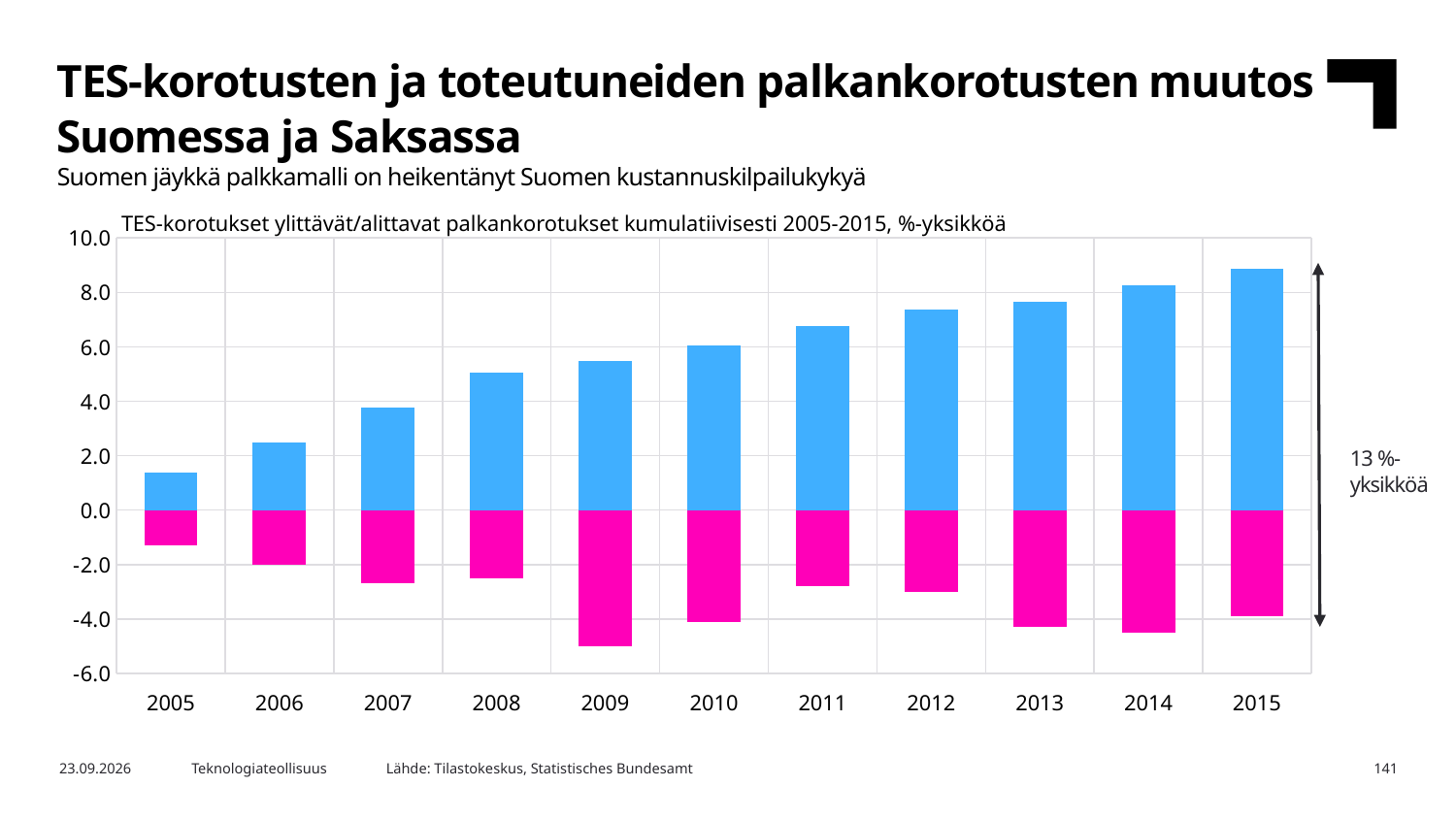
Is the blue bar value for 2005 greater or less than 2.0? less Is the blue bar value for 2015 greater or less than 8.0? greater What is the subtitle printed above the chart? TES-korotukset ylittävät/alittavat palkankorotukset kumulatiivisesti 2005-2015, %-yksikköä Is the magenta bar value for 2011 greater or less than -4.0? greater Which year has the larger blue bar, 2007 or 2010? 2010 Which year has the longest magenta (negative) bar? 2009 What kind of chart is shown on the slide? bar chart Which year has the highest blue (positive) bar? 2015 Which year has the lowest blue (positive) bar? 2005 How many years are shown on the x axis of the chart? 11 Do the blue (positive) bars rise or fall from 2005 to 2015? rise